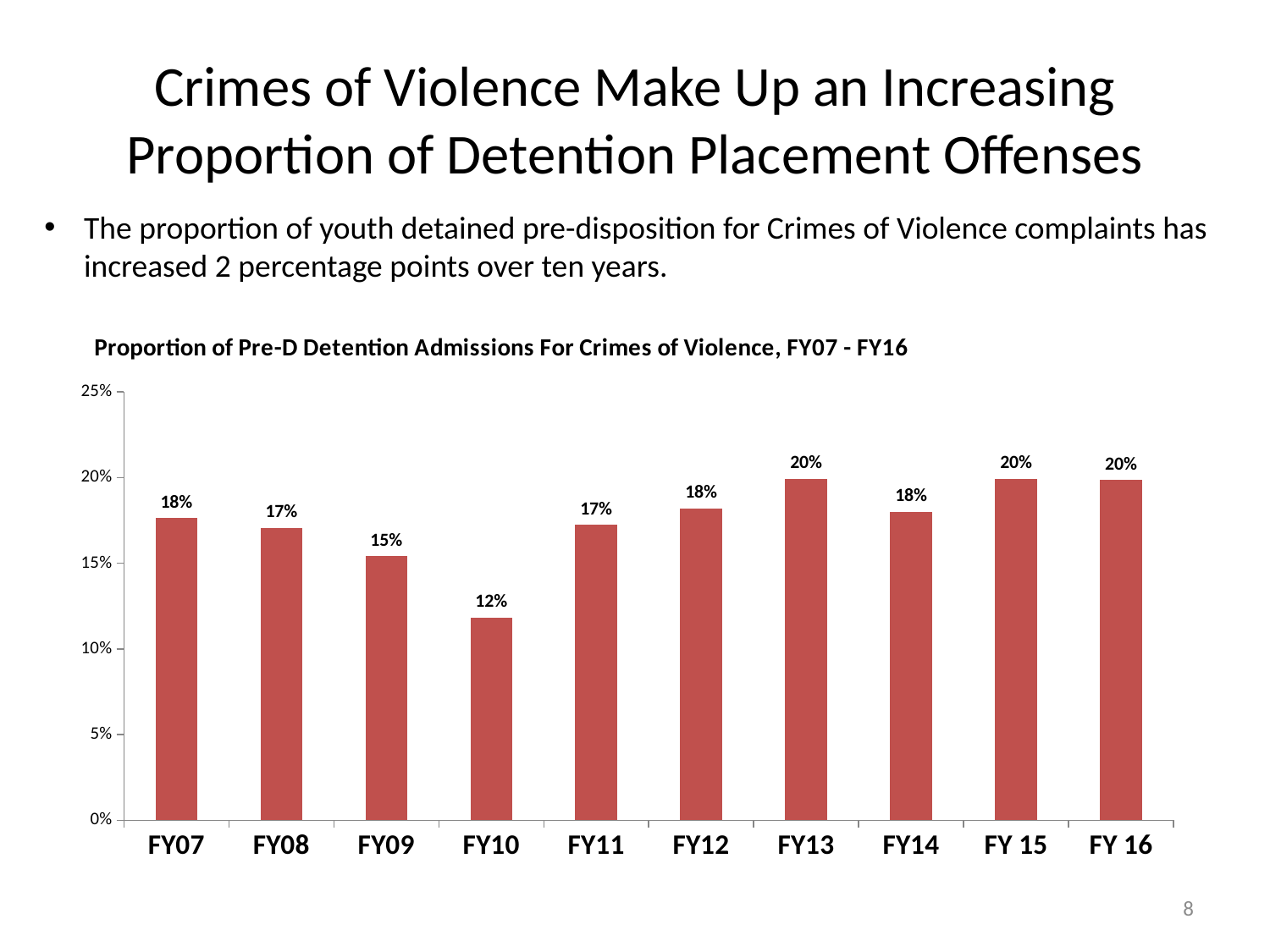
What is the value for FY13? 20% Which is larger, the value for FY10 or the value for FY13? FY13 What is the difference between the values for FY16 and FY09? 5 percentage points How many fiscal years are shown on the x axis? 10 Do the values rise or fall from FY10 to FY13? rise What is the title of the chart? Proportion of Pre-D Detention Admissions For Crimes of Violence, FY07 - FY16 Is the value for FY10 greater or less than 15%? less What kind of chart is shown on the slide? bar chart What is the value for FY09? 15% Which fiscal year has the lowest proportion? FY10 What is the difference between the values for FY07 and FY10? 6 percentage points What is the value for FY10? 12%